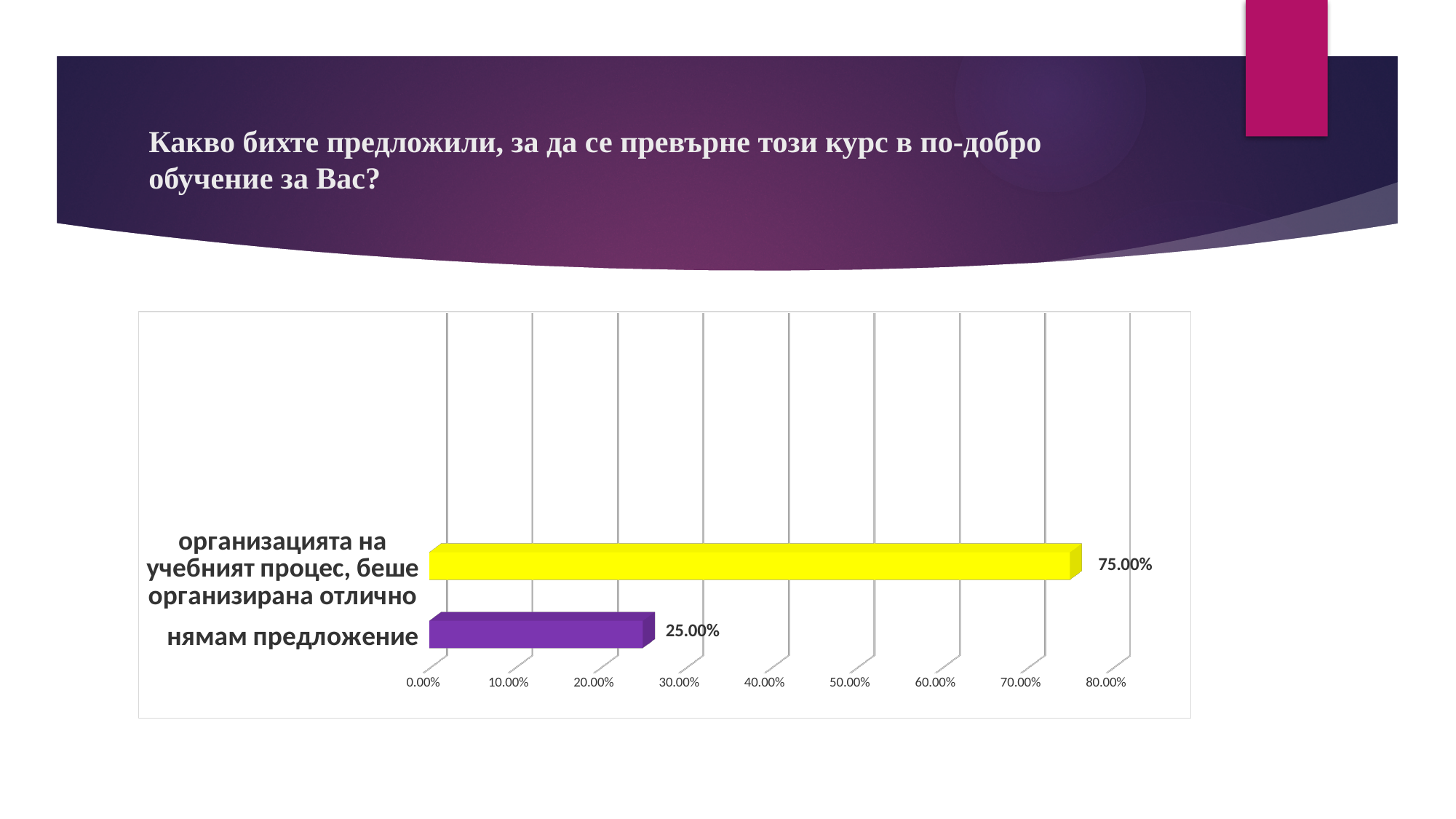
How many categories are shown in the chart? 2 Which category has the lowest value? нямам предложение What kind of chart is shown on the slide? bar chart Which is larger: the value for "нямам предложение" or the value for "организацията на учебният процес, беше организирана отлично"? организацията на учебният процес, беше организирана отлично Which category has the highest value? организацията на учебният процес, беше организирана отлично What colour is the bar for "нямам предложение"? purple Is the value for "организацията на учебният процес, беше организирана отлично" greater or less than 70.00%? greater Is the value for "нямам предложение" greater or less than 30.00%? less What is the total of the two values shown in the chart? 100.00% What is the value for "организацията на учебният процес, беше организирана отлично"? 75.00% What is the difference between the values for "организацията на учебният процес, беше организирана отлично" and "нямам предложение"? 50.00% What is the value for "нямам предложение"? 25.00%